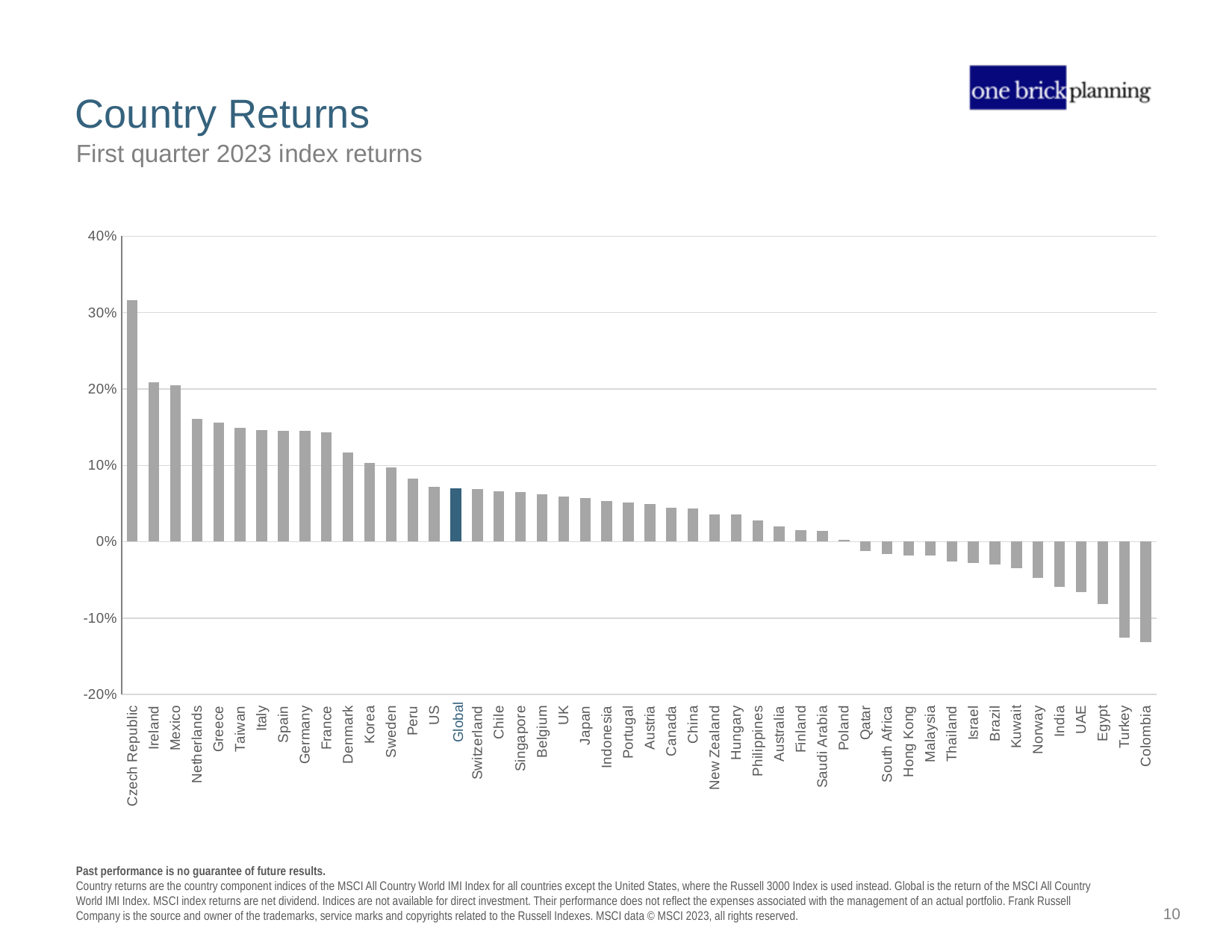
Is the value for Netherlands greater or less than 20%? less Which has the larger return, Germany or Denmark? Germany Is the value for Global greater or less than 10%? less Is the value for Czech Republic greater or less than 30%? greater Which country has the highest first quarter 2023 return? Czech Republic How many categories (countries plus Global) are plotted on the chart? 48 Which bar is highlighted in a different (dark blue) colour from the others? Global Do the values rise or fall moving from left to right along the x axis? fall Which country has the lowest first quarter 2023 return? Colombia What kind of chart is shown on the slide? bar chart